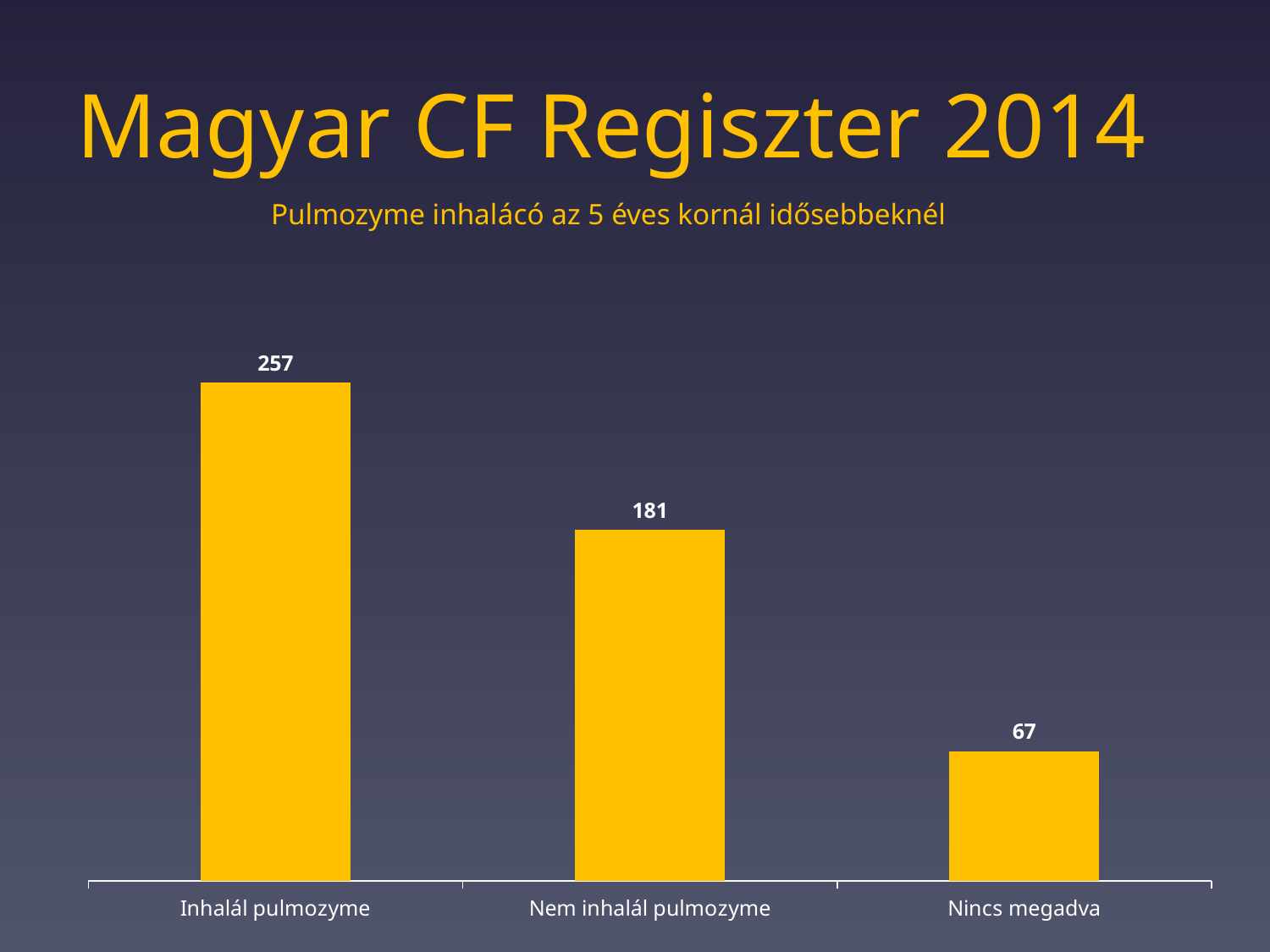
What is the value for Nem inhalál pulmozyme? 181 What is the difference between the values for Inhalál pulmozyme and Nem inhalál pulmozyme? 76 Which category has the highest value? Inhalál pulmozyme What is the subtitle of the chart shown on the slide? Pulmozyme inhalácó az 5 éves kornál idősebbeknél Which is larger, the value for Nem inhalál pulmozyme or the value for Nincs megadva? Nem inhalál pulmozyme What kind of chart is shown on the slide? Bar chart What is the value for Nincs megadva? 67 What is the difference between the values for Nem inhalál pulmozyme and Nincs megadva? 114 How many categories are shown in the chart? 3 What is the value for Inhalál pulmozyme? 257 Which category has the lowest value? Nincs megadva Do the values rise or fall from left to right across the categories? Fall